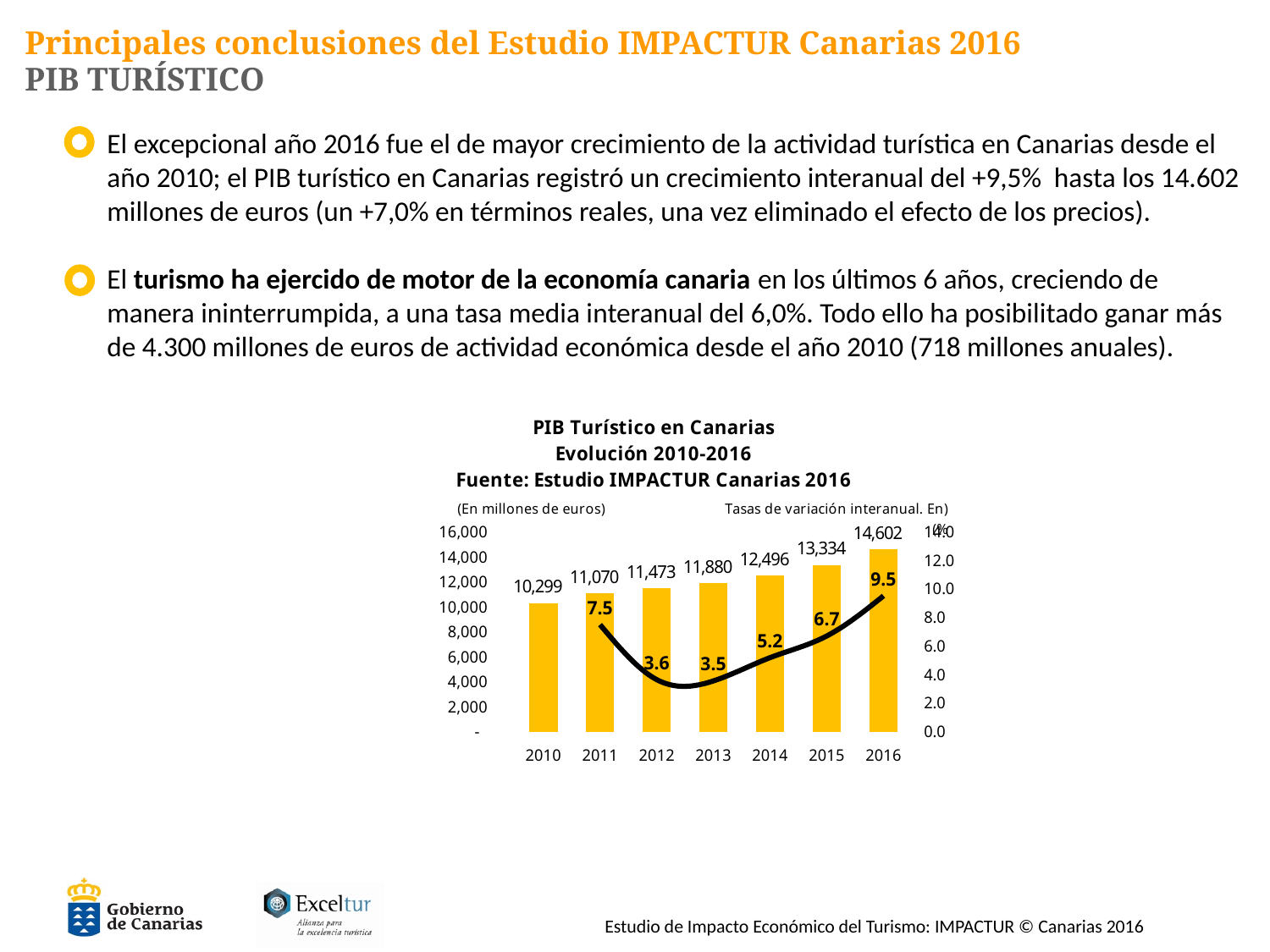
Which year has a higher year-on-year variation rate, 2011 or 2015? 2011 Do the PIB turístico bar values rise or fall from 2010 to 2016? rise What is the difference between the PIB turístico values for 2016 and 2015? 1,268 What kind of chart is used to show the PIB turístico values in millions of euros? bar chart What is the year-on-year variation rate shown for 2014? 5.2 What is the PIB turístico value (in millions of euros) shown for 2010? 10,299 Is the PIB turístico value for 2013 greater or less than 12,000? less Which year has the lowest year-on-year variation rate on the line? 2013 What source is cited in the chart title? Estudio IMPACTUR Canarias 2016 How many years are shown on the x axis of the chart? 7 What is the PIB turístico value (in millions of euros) shown for 2016? 14,602 Which year has the highest PIB turístico value? 2016